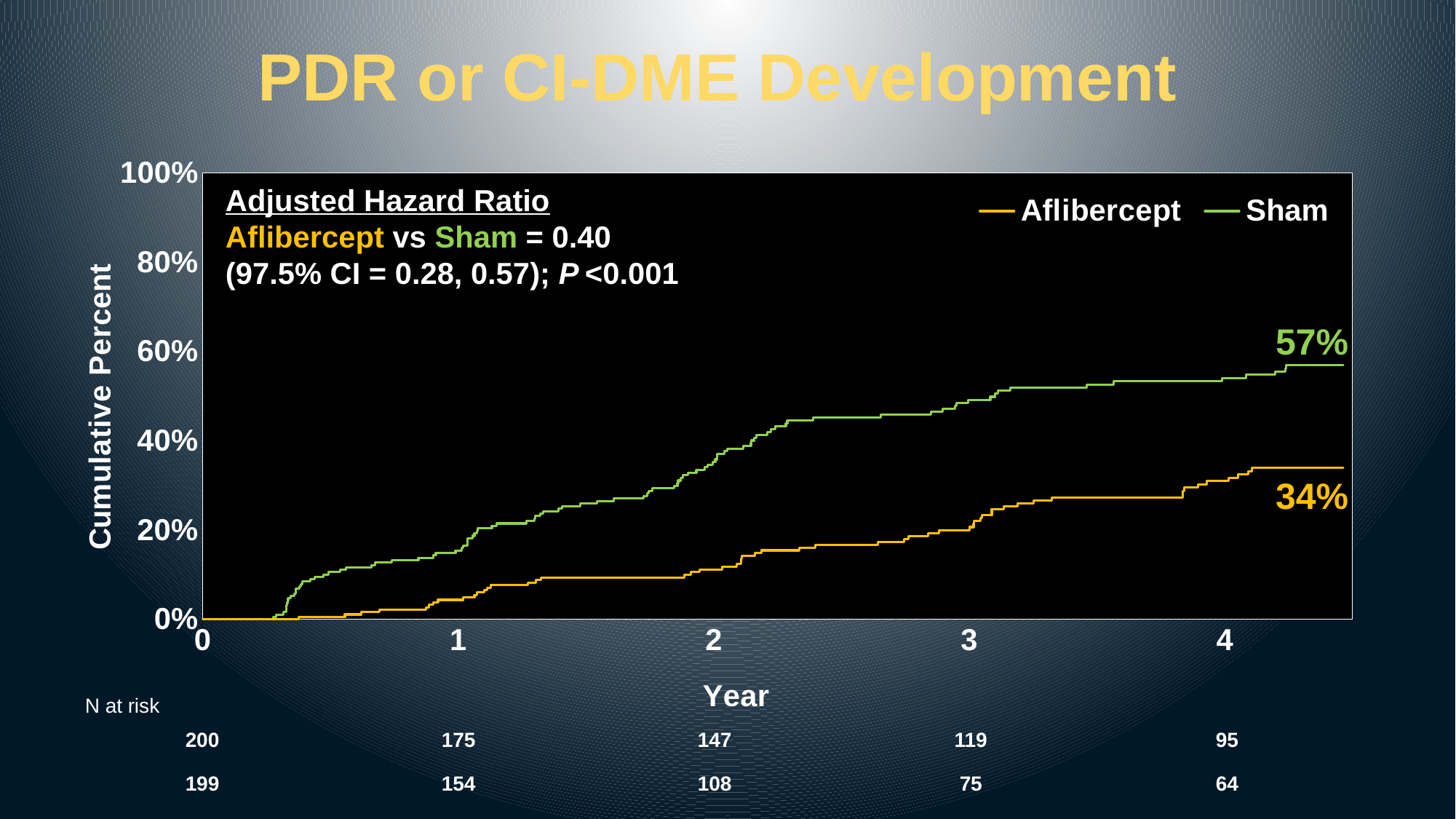
What kind of chart is shown on the slide? Line chart What is the difference between the final cumulative percent for Sham and for Aflibercept? 23 percentage points What is the adjusted hazard ratio for Aflibercept vs Sham shown on the chart? 0.40 Which group has the higher cumulative percent at the end of follow-up, Aflibercept or Sham? Sham Is the cumulative percent for Sham at year 2 greater or less than 40%? less How many series does the legend list? 2 Which group has the lower cumulative percent at the end of follow-up? Aflibercept What is the final cumulative percent shown for the Aflibercept group? 34% What is the final cumulative percent shown for the Sham group? 57% Do the cumulative percent curves rise or fall as the years increase? Rise What is the title of the chart? PDR or CI-DME Development Is the cumulative percent for Sham at year 3 greater or less than 40%? greater